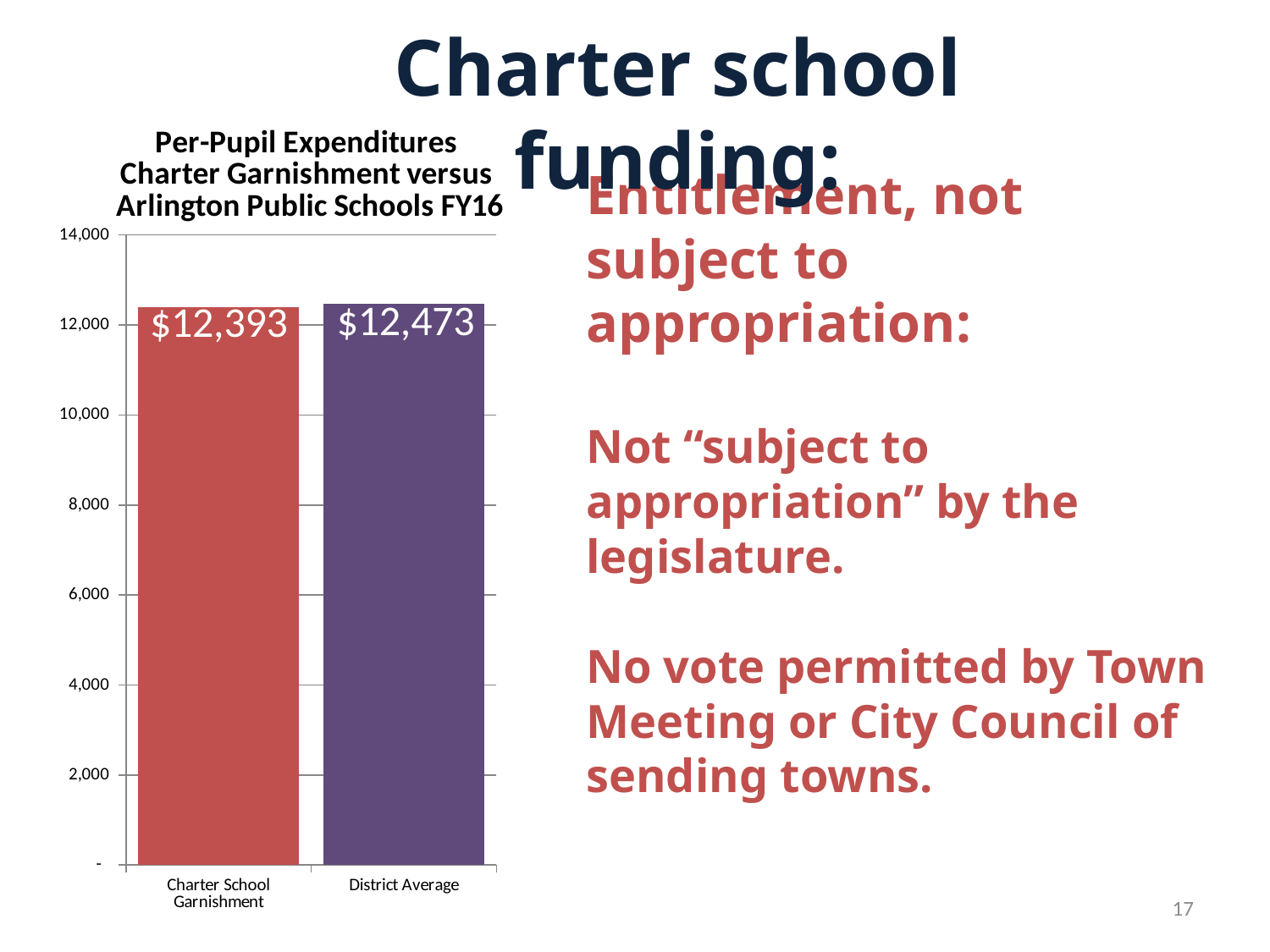
What colour is the bar for Charter School Garnishment? red What kind of chart is shown on the slide? bar chart What is the title of the chart? Per-Pupil Expenditures Charter Garnishment versus Arlington Public Schools FY16 Which category has the higher per-pupil expenditure? District Average What is the per-pupil expenditure value shown for District Average? $12,473 What is the per-pupil expenditure value shown for Charter School Garnishment? $12,393 What is the difference between the District Average and the Charter School Garnishment per-pupil expenditures? $80 Is the value for Charter School Garnishment larger or smaller than the value for District Average? smaller How many categories are plotted in the chart? 2 Is the value for District Average greater or less than 12,000? greater Is the value for Charter School Garnishment greater or less than 14,000? less Which category has the lower per-pupil expenditure? Charter School Garnishment